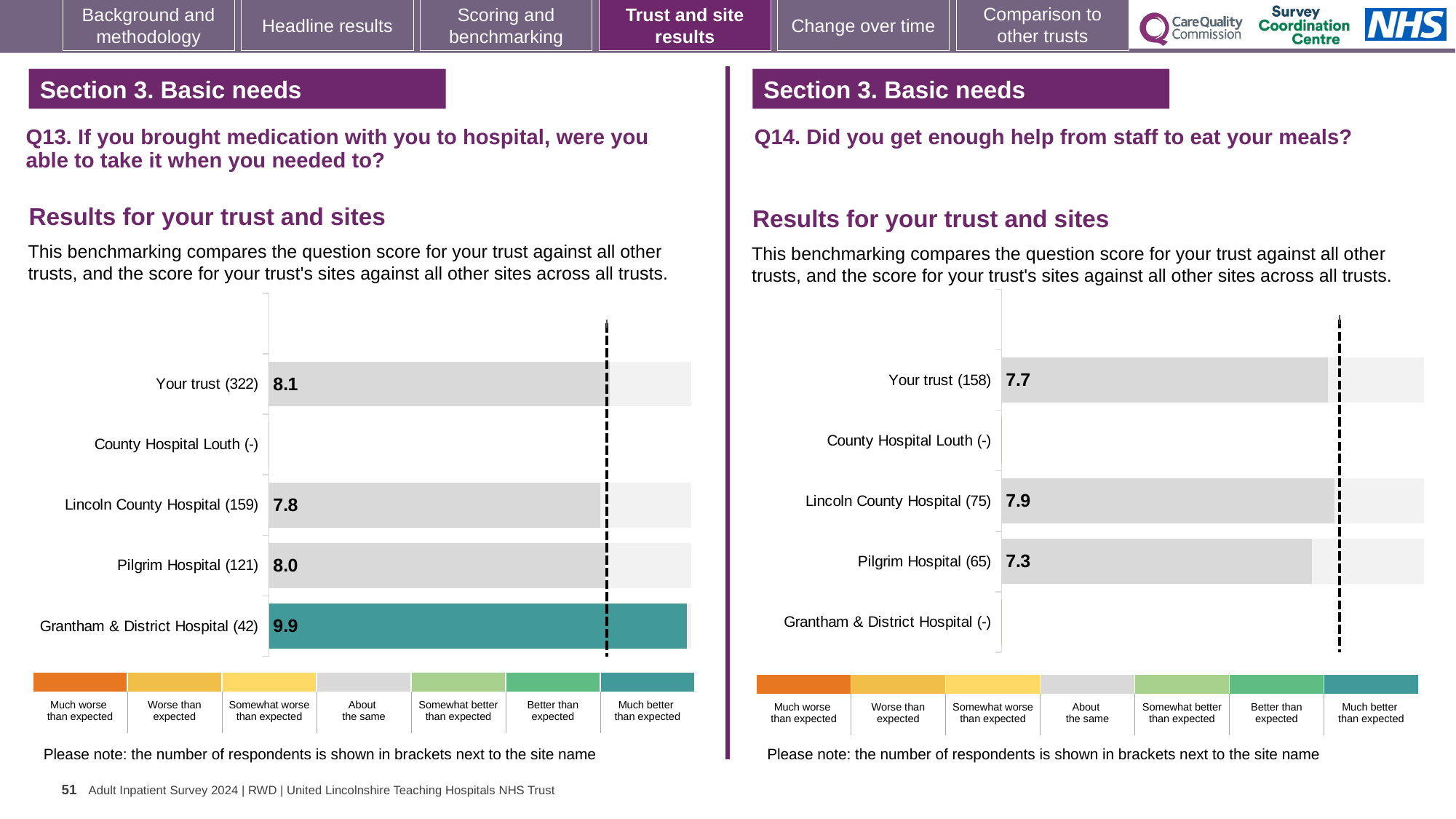
In the Q13 chart on the left, how many respondents are shown in brackets for Your trust? 322 In the Q14 chart on the right, what is the difference between the scores for Lincoln County Hospital and Pilgrim Hospital? 0.6 In the Q13 chart on the left, what is the score for Grantham & District Hospital? 9.9 In the Q14 chart on the right, which site has the highest score? Lincoln County Hospital In the Q14 chart on the right, how many sites have a score bar shown? 3 In the Q14 chart on the right, what is the score for Pilgrim Hospital? 7.3 In the Q13 chart on the left, which site with a score shown has the lowest score? Lincoln County Hospital In the Q13 chart on the left, which site has the highest score? Grantham & District Hospital In the Q13 chart on the left, what is the difference between the scores for Grantham & District Hospital and Pilgrim Hospital? 1.9 What kind of chart is used on the left for Q13? Bar chart In the Q14 chart on the right, which is larger, the score for Your trust or the score for Pilgrim Hospital? Your trust In the Q13 chart on the left, what is the score for Your trust? 8.1